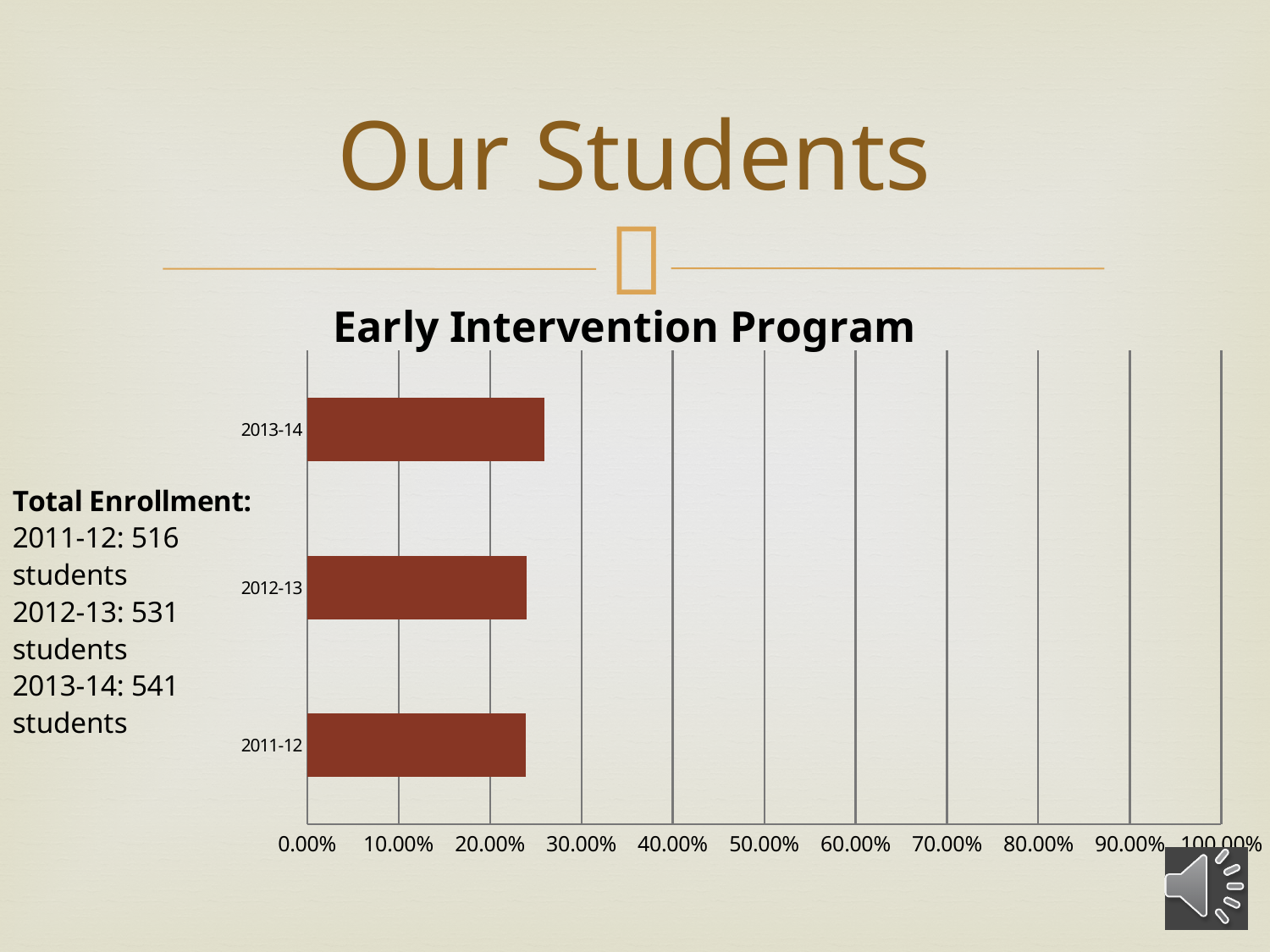
Is the value for 2011-12 greater or less than 30.00%? less What is the maximum value shown on the horizontal axis? 100.00% Is the value for 2013-14 greater or less than 30.00%? less Which school year has the highest value in the chart? 2013-14 How many school years are plotted in the chart? 3 What is the title of the chart? Early Intervention Program What kind of chart is shown on the slide? bar chart Is the value for 2011-12 greater or less than 20.00%? greater Which is larger, the value for 2013-14 or the value for 2012-13? 2013-14